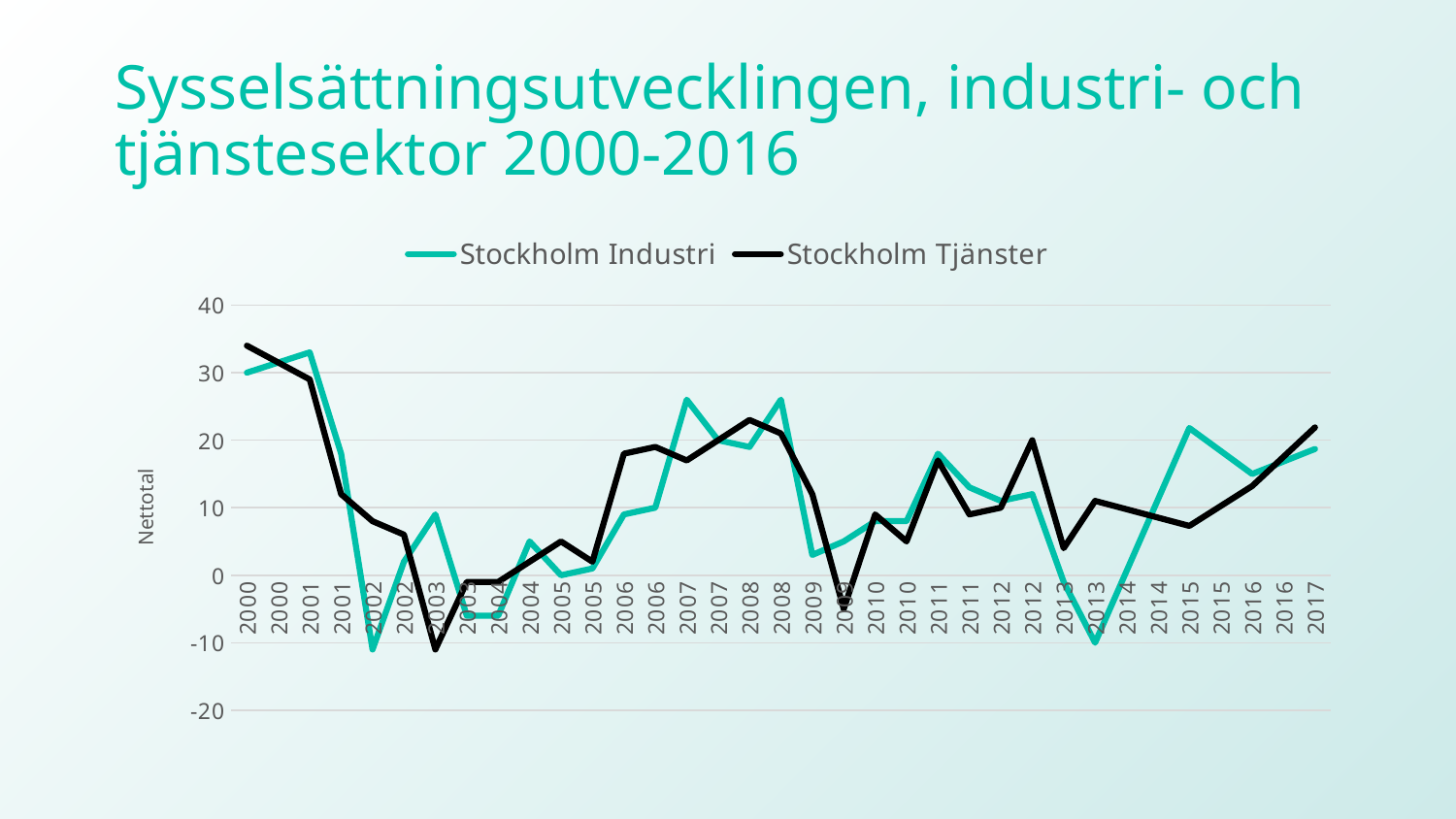
At which year does Stockholm Tjänster reach its lowest value? 2003 Do the values for Stockholm Tjänster rise or fall from 2000 to 2002? fall At the first 2007 point, which series has the higher value, Stockholm Industri or Stockholm Tjänster? Stockholm Industri What are the two series named in the legend? Stockholm Industri and Stockholm Tjänster What kind of chart is shown on the slide? line chart Is the value for Stockholm Tjänster at the first 2000 point greater or less than 30? greater How many series does the legend list? 2 At the second 2013 point, which series has the higher value, Stockholm Industri or Stockholm Tjänster? Stockholm Tjänster Is the value for Stockholm Tjänster at 2017 greater or less than 20? greater What is the label on the vertical axis? Nettotal